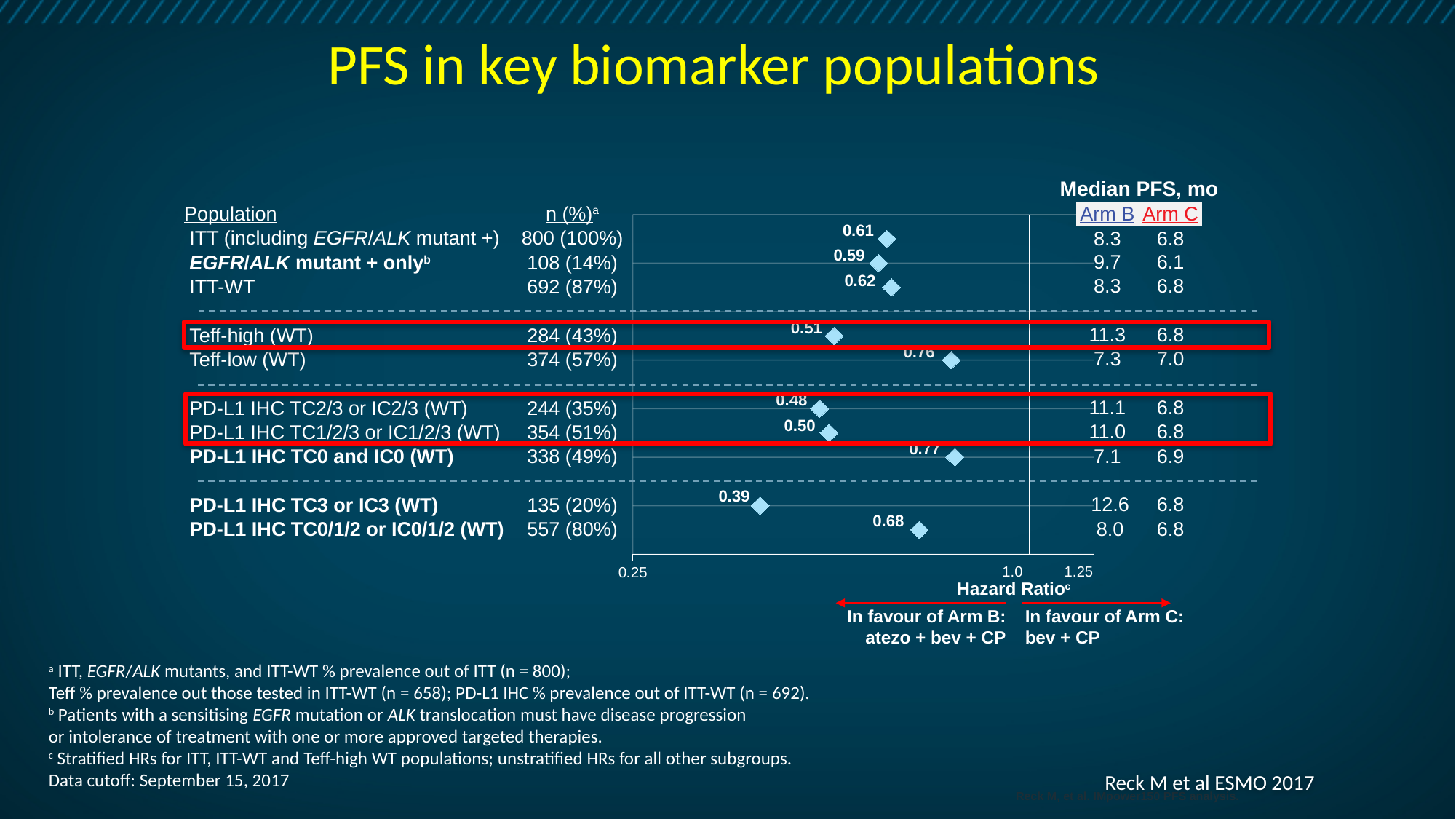
Which population has the lowest hazard ratio on the chart? PD-L1 IHC TC3 or IC3 (WT) Which has the larger hazard ratio: PD-L1 IHC TC0/1/2 or IC0/1/2 (WT) or PD-L1 IHC TC2/3 or IC2/3 (WT)? PD-L1 IHC TC0/1/2 or IC0/1/2 (WT) What is the difference between the hazard ratios for Teff-low (WT) and Teff-high (WT)? 0.25 How many populations are plotted on the hazard ratio chart? 10 What is the hazard ratio plotted for the ITT (including EGFR/ALK mutant +) population? 0.61 What is the title of the slide containing the hazard ratio chart? PFS in key biomarker populations Is the hazard ratio for PD-L1 IHC TC0 and IC0 (WT) greater or less than 1.0? less Which population has the highest hazard ratio on the chart? PD-L1 IHC TC0 and IC0 (WT) What is the hazard ratio plotted for the PD-L1 IHC TC3 or IC3 (WT) population? 0.39 What is the median PFS in months for Arm B in the Teff-high (WT) population? 11.3 What is the hazard ratio plotted for the Teff-high (WT) population? 0.51 What is the median PFS in months for Arm C in the EGFR/ALK mutant + only population? 6.1